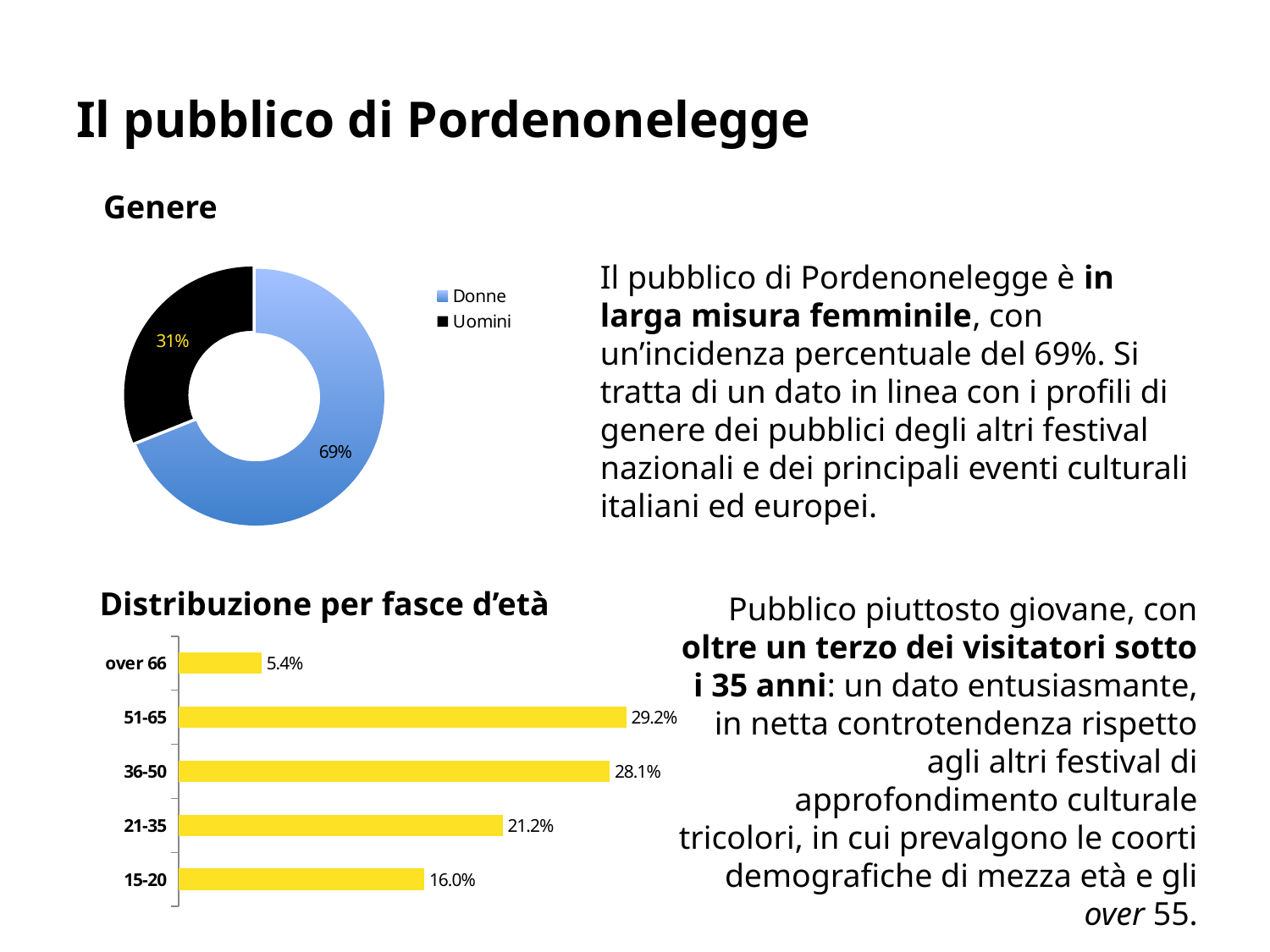
In the 'Genere' chart, what percentage is shown for Uomini? 31% How many age groups are shown in the 'Distribuzione per fasce d'età' chart? 5 In the 'Distribuzione per fasce d'età' chart, which age group has the highest value? 51-65 In the 'Genere' chart, which slice is larger, Donne or Uomini? Donne In the 'Genere' chart, what percentage is shown for Donne? 69% What kind of chart is the 'Genere' chart? Donut chart In the 'Distribuzione per fasce d'età' chart, what is the value for 51-65? 29.2% In the 'Distribuzione per fasce d'età' chart, which age group has the lowest value? over 66 In the 'Distribuzione per fasce d'età' chart, what is the value for 15-20? 16.0% What kind of chart is the 'Distribuzione per fasce d'età' chart? Bar chart In the 'Distribuzione per fasce d'età' chart, what is the difference between the values for 36-50 and 21-35? 6.9% How many entries does the legend of the 'Genere' chart list? 2